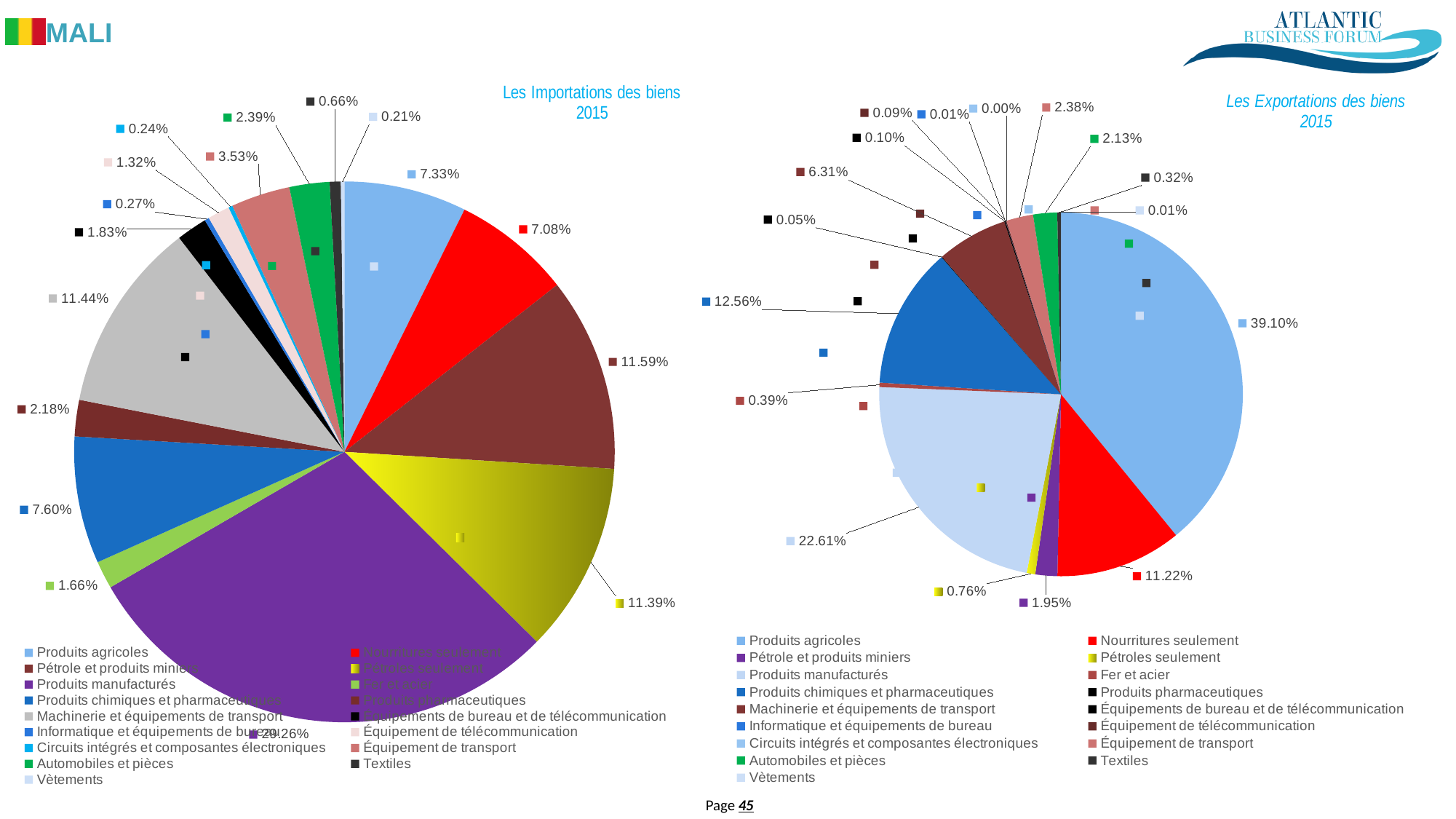
In 'Les Importations des biens 2015', which is larger: Produits agricoles or Nourritures seulement? Produits agricoles In 'Les Importations des biens 2015', which category has the largest share? Produits manufacturés How many categories does the legend of 'Les Exportations des biens 2015' list? 17 What kind of chart is 'Les Importations des biens 2015'? Pie chart In 'Les Importations des biens 2015', what share does Machinerie et équipements de transport have? 11.44% In 'Les Exportations des biens 2015', what share do Produits agricoles have? 39.10% In 'Les Exportations des biens 2015', what share do Produits chimiques et pharmaceutiques have? 12.56% In 'Les Importations des biens 2015', what share do Produits manufacturés have? 29.26% In 'Les Exportations des biens 2015', which is larger: Nourritures seulement or Machinerie et équipements de transport? Nourritures seulement In 'Les Exportations des biens 2015', which category has the largest share? Produits agricoles In 'Les Importations des biens 2015', what is the difference between Produits manufacturés and Pétrole et produits miniers? 17.67% In 'Les Exportations des biens 2015', what is the difference between Produits agricoles and Produits manufacturés? 16.49%